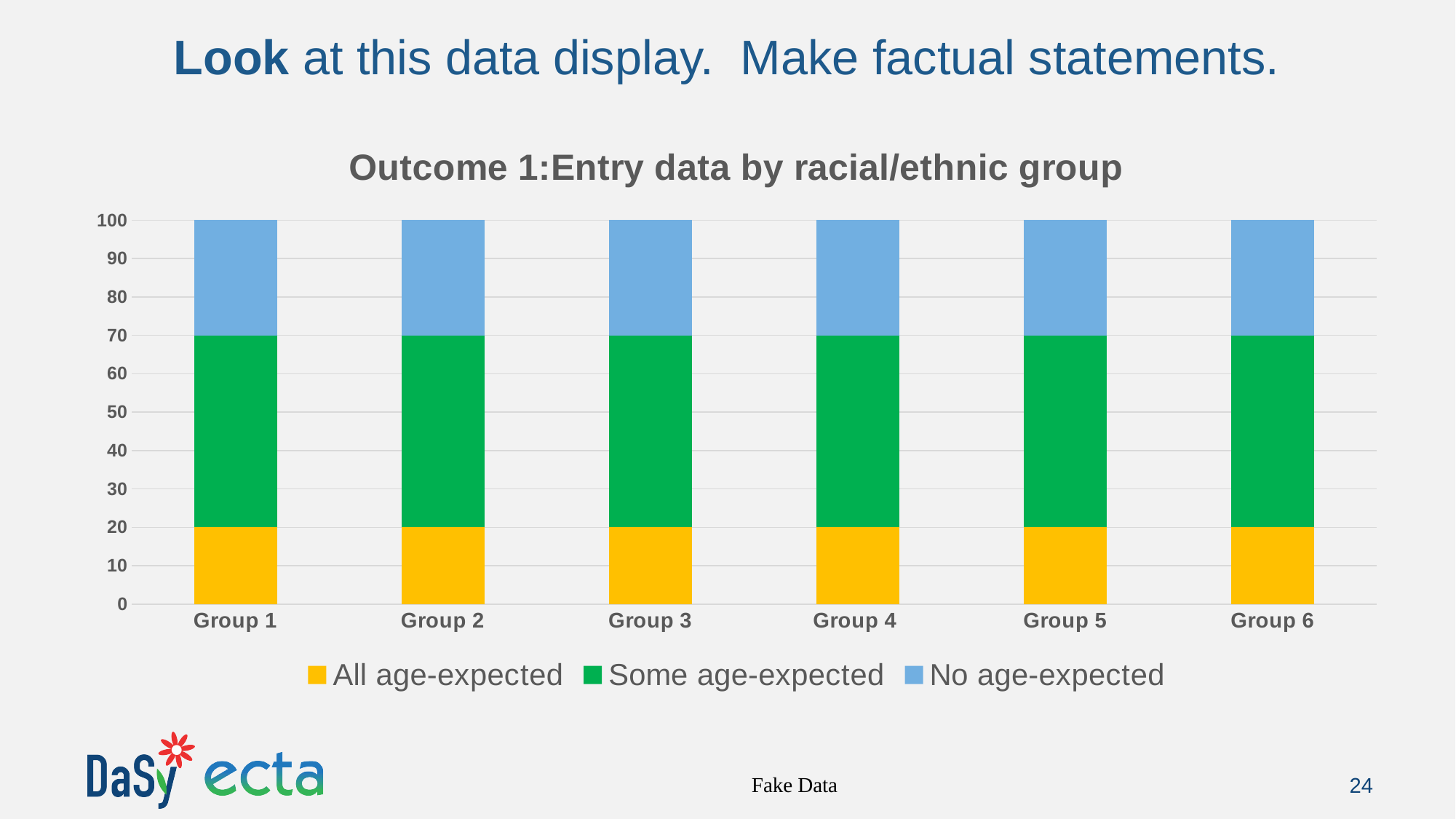
How many groups are shown on the x axis of the chart? 6 Do the total bar heights rise, fall, or stay the same from Group 1 to Group 6? Stay the same What is the value of the All age-expected segment for Group 1? 20 Which series is shown in yellow in the chart? All age-expected How many series does the chart's legend list? 3 Is the value of the No age-expected segment for Group 5 greater or less than 40? less What is the total height of the stacked bar for Group 6? 100 What is the title of the chart? Outcome 1:Entry data by racial/ethnic group What is the value of the All age-expected segment for Group 4? 20 What is the total height of the stacked bar for Group 3? 100 Is the value of the Some age-expected segment for Group 2 greater or less than 40? greater What kind of chart is shown on the slide? Stacked bar chart